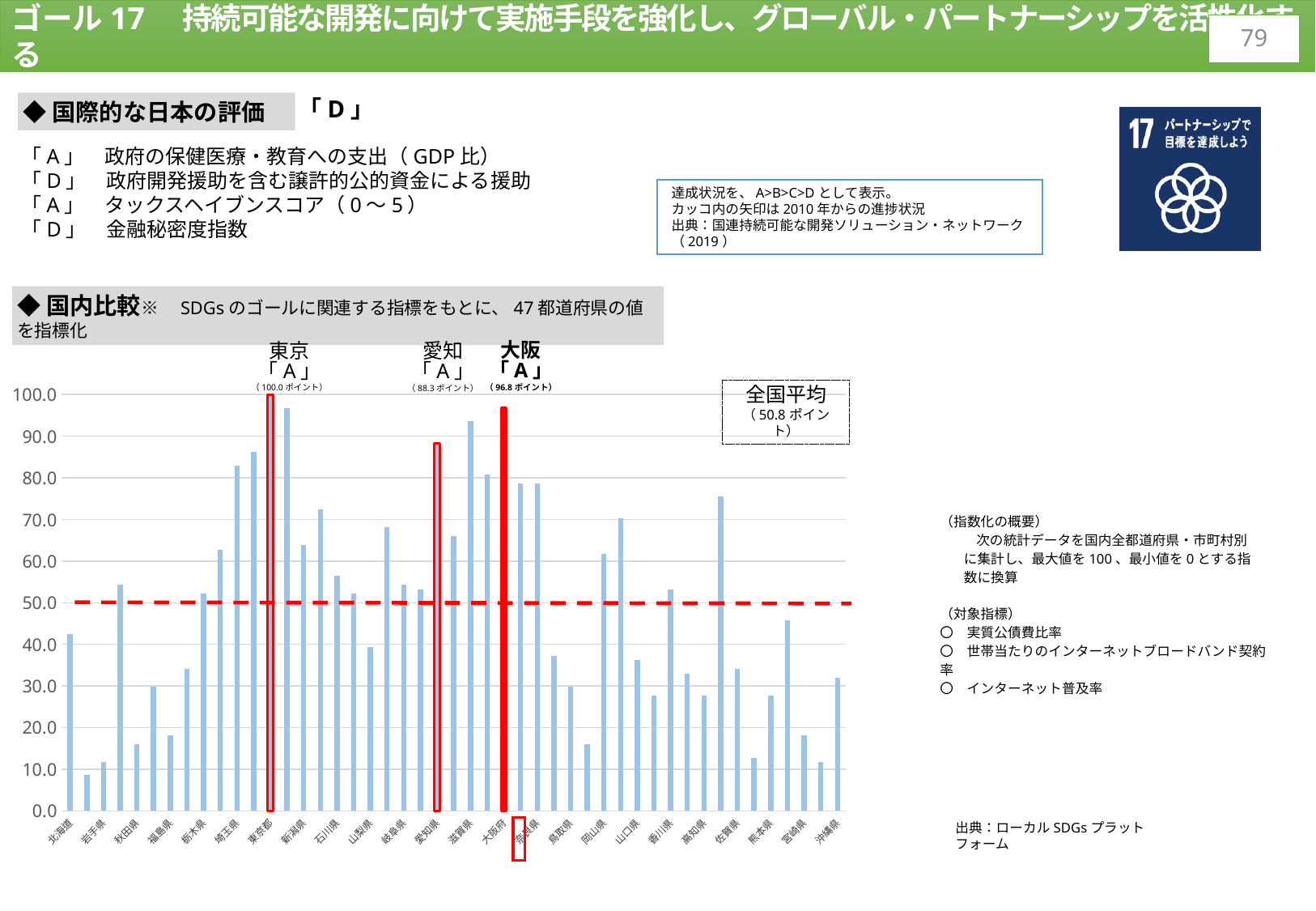
Which prefecture has the highest bar in the chart? 東京都 Which has the larger value, 大阪 or 愛知? 大阪 What kind of chart is used for the 国内比較 section? bar chart Is the value for 埼玉県 greater or less than 80? greater What is the value for 大阪 in the 国内比較 bar chart? 96.8 ポイント What is the difference between the values for 東京 and 大阪? 3.2 ポイント Is the value for 沖縄県 greater or less than 40? less What is the 全国平均 value shown on the chart? 50.8 ポイント What is the difference between the values for 大阪 and 愛知? 8.5 ポイント Is the value for 北海道 greater or less than 50? less What is the value for 愛知 in the 国内比較 bar chart? 88.3 ポイント What is the value for 東京 in the 国内比較 bar chart? 100.0 ポイント